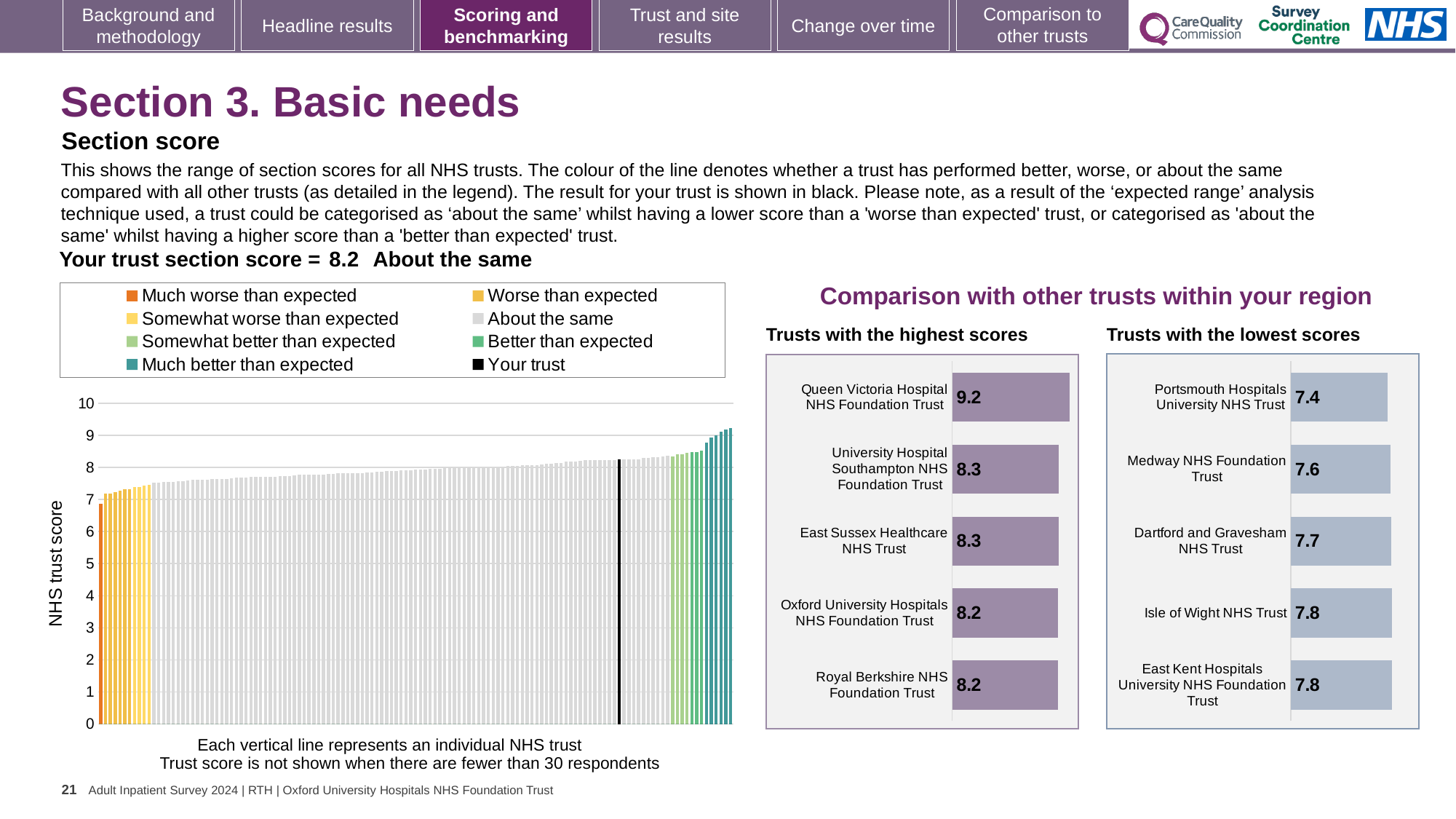
In the 'Trusts with the highest scores' chart, which trust has the highest score? Queen Victoria Hospital NHS Foundation Trust In the 'Trusts with the lowest scores' chart, what is the difference between the scores of Isle of Wight NHS Trust and Portsmouth Hospitals University NHS Trust? 0.4 According to the legend of the main chart, what colour represents 'Your trust'? black What is the section score for your trust shown on the slide? 8.2 In the 'Trusts with the highest scores' chart, what is the difference between the scores of Queen Victoria Hospital NHS Foundation Trust and Royal Berkshire NHS Foundation Trust? 1.0 In the 'Trusts with the lowest scores' chart, what is the score for Medway NHS Foundation Trust? 7.6 In the 'Trusts with the highest scores' chart, what is the score for Queen Victoria Hospital NHS Foundation Trust? 9.2 How many entries does the legend of the main 'NHS trust score' chart list? 8 How many trusts are shown in the 'Trusts with the highest scores' chart? 5 What kind of chart is the main 'NHS trust score' chart on the left? bar chart In the 'Trusts with the lowest scores' chart, which trust has the lowest score? Portsmouth Hospitals University NHS Trust In the 'Trusts with the lowest scores' chart, which has the larger score: Dartford and Gravesham NHS Trust or Medway NHS Foundation Trust? Dartford and Gravesham NHS Trust